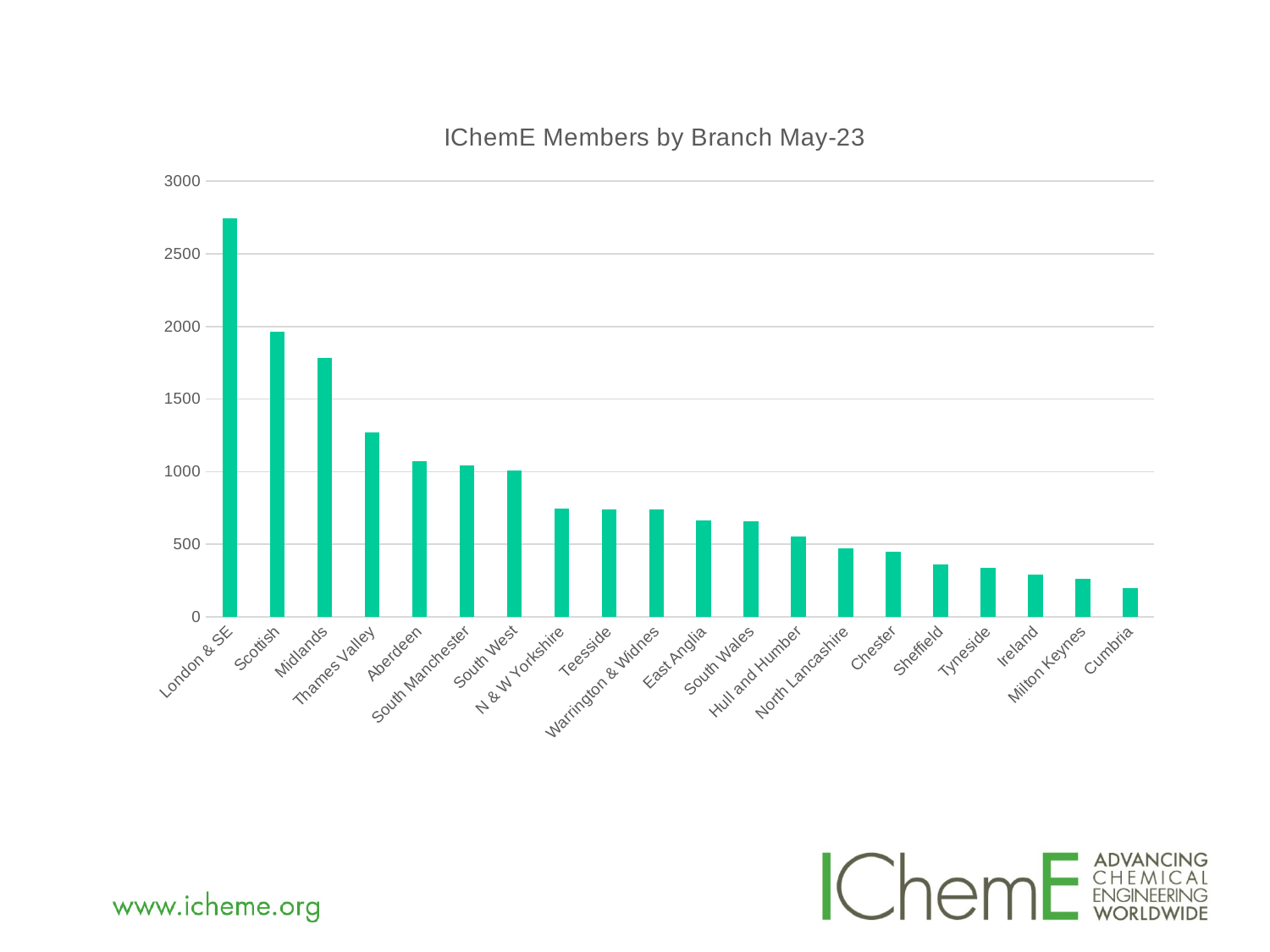
Which branch has the lowest number of members? Cumbria Is the value for London & SE greater or less than 2500? greater Which branch has the highest number of members? London & SE What kind of chart is shown on the slide? bar chart How many branches are shown on the x axis of the chart? 20 Is the value for Midlands greater or less than 1500? greater Is the value for Thames Valley greater or less than 1000? greater Do the values rise or fall moving from left to right along the x axis? fall What is the title of the chart? IChemE Members by Branch May-23 Which has more members, Midlands or Thames Valley? Midlands